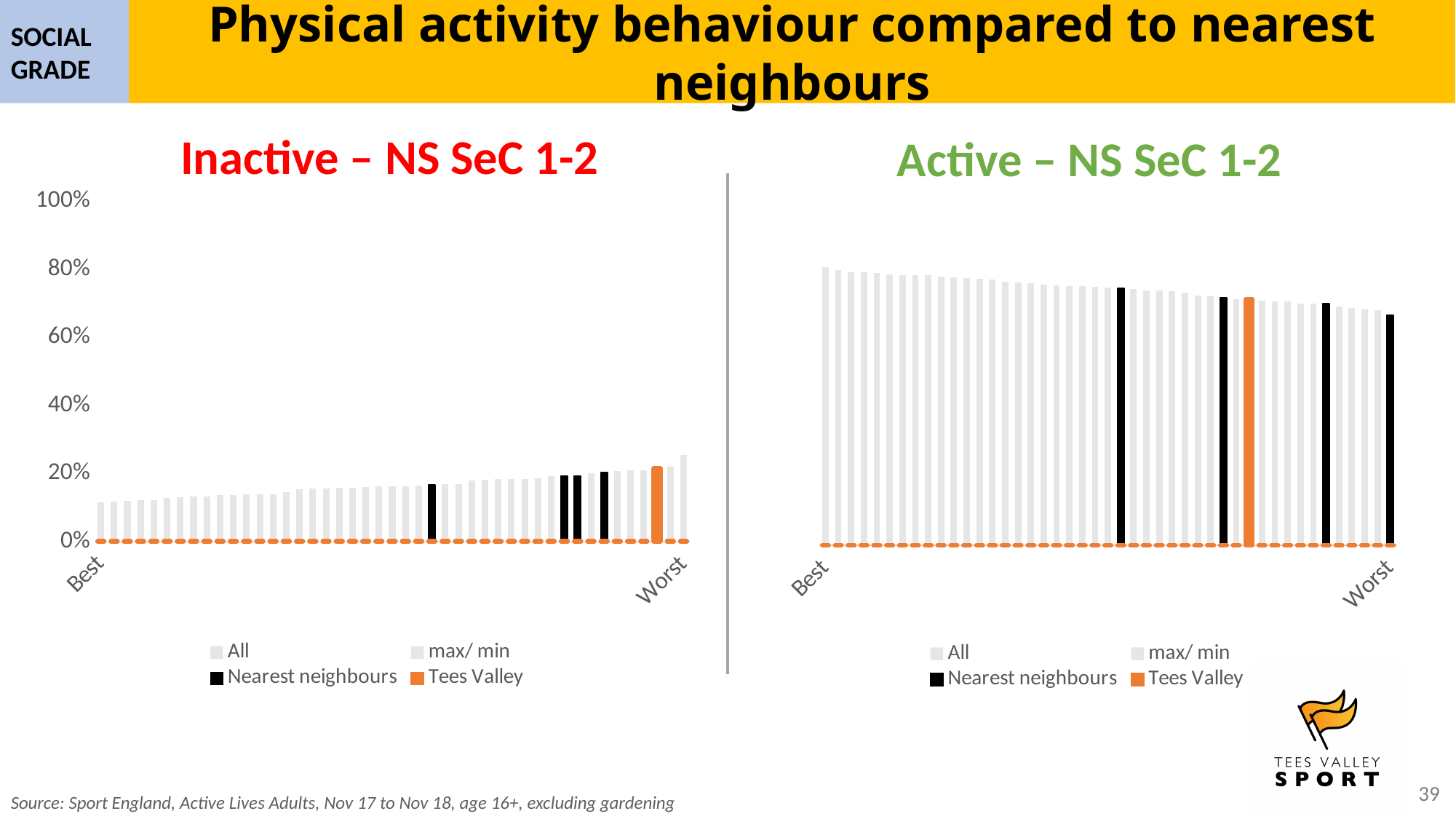
In the 'Inactive – NS SeC 1-2' chart, do the bar values rise or fall from Best to Worst along the x axis? rise What type of chart is the 'Inactive – NS SeC 1-2' chart? bar chart What colour represents Tees Valley in the 'Active – NS SeC 1-2' chart? orange In the 'Active – NS SeC 1-2' chart, is the Tees Valley bar taller or shorter than the bar at the Best end of the axis? shorter In the 'Inactive – NS SeC 1-2' chart, is the Tees Valley bar taller or shorter than the bar at the Best end of the axis? taller In the 'Active – NS SeC 1-2' chart, do the bar values rise or fall from Best to Worst along the x axis? fall In the 'Active – NS SeC 1-2' chart, is the value for Tees Valley greater or less than 60%? greater Which legend entry is shown in black in the 'Inactive – NS SeC 1-2' chart? Nearest neighbours In the 'Inactive – NS SeC 1-2' chart, is the value for Tees Valley greater or less than 40%? less In the 'Inactive – NS SeC 1-2' chart, is the value for Tees Valley greater or less than 10%? greater How many series does the legend of the 'Active – NS SeC 1-2' chart list? 4